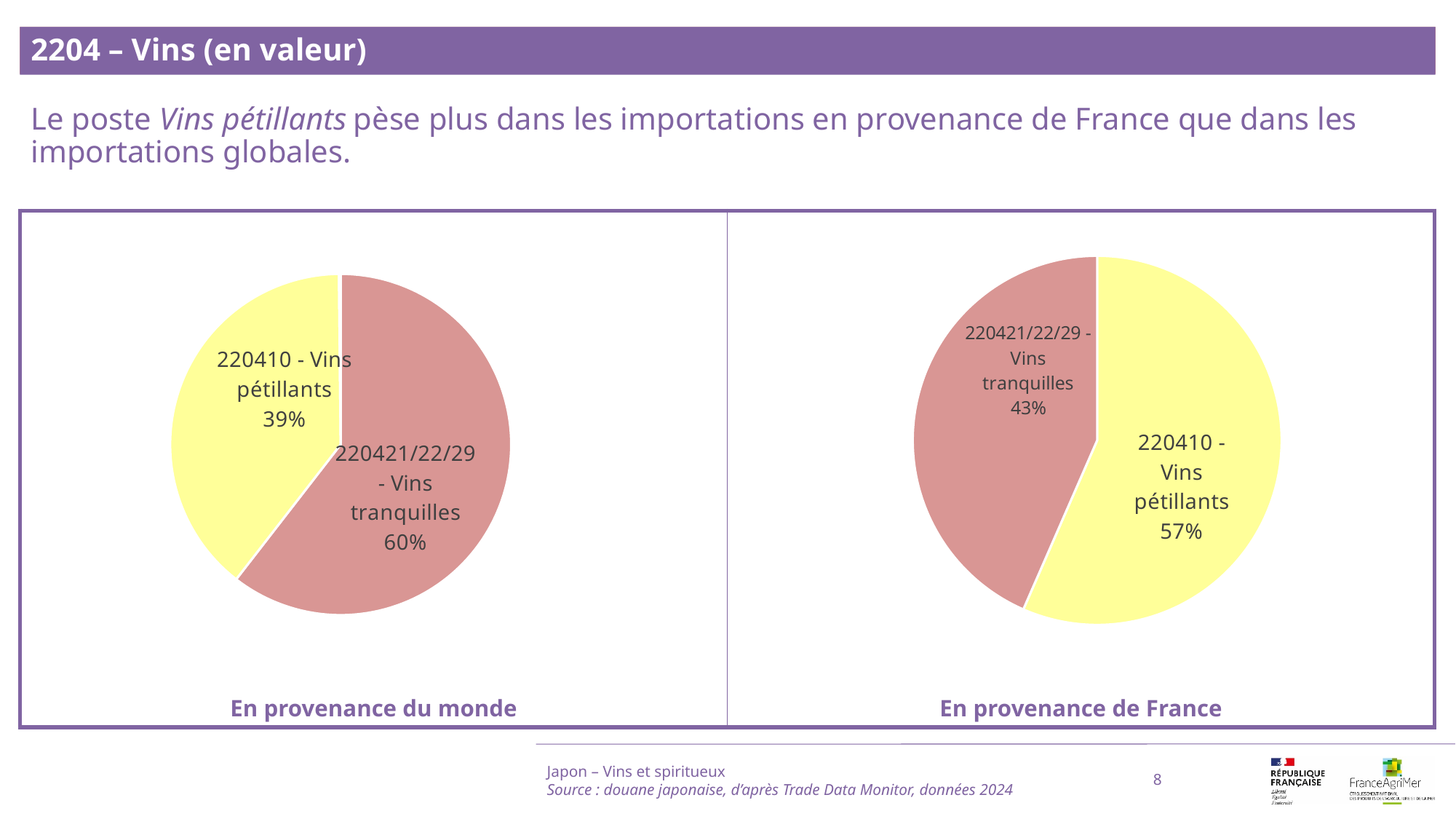
In the 'En provenance de France' pie chart, which category has the smallest slice? 220421/22/29 - Vins tranquilles In the 'En provenance de France' pie chart, what share is shown for 220410 - Vins pétillants? 57% In the 'En provenance du monde' pie chart, which category has the largest slice? 220421/22/29 - Vins tranquilles In the 'En provenance du monde' pie chart, what share is shown for 220410 - Vins pétillants? 39% How many slices does the 'En provenance de France' pie chart have? 2 In the 'En provenance du monde' pie chart, what is the difference between the Vins tranquilles share and the Vins pétillants share? 21 percentage points What type of chart is used on this slide? Pie chart What is the difference between the share of Vins pétillants in the 'En provenance de France' chart and in the 'En provenance du monde' chart? 18 percentage points What colour is the Vins pétillants slice in both pie charts? Yellow In the 'En provenance du monde' pie chart, what share is shown for 220421/22/29 - Vins tranquilles? 60% Is the share of Vins pétillants larger in the 'En provenance du monde' chart or in the 'En provenance de France' chart? En provenance de France In the 'En provenance de France' pie chart, what share is shown for 220421/22/29 - Vins tranquilles? 43%